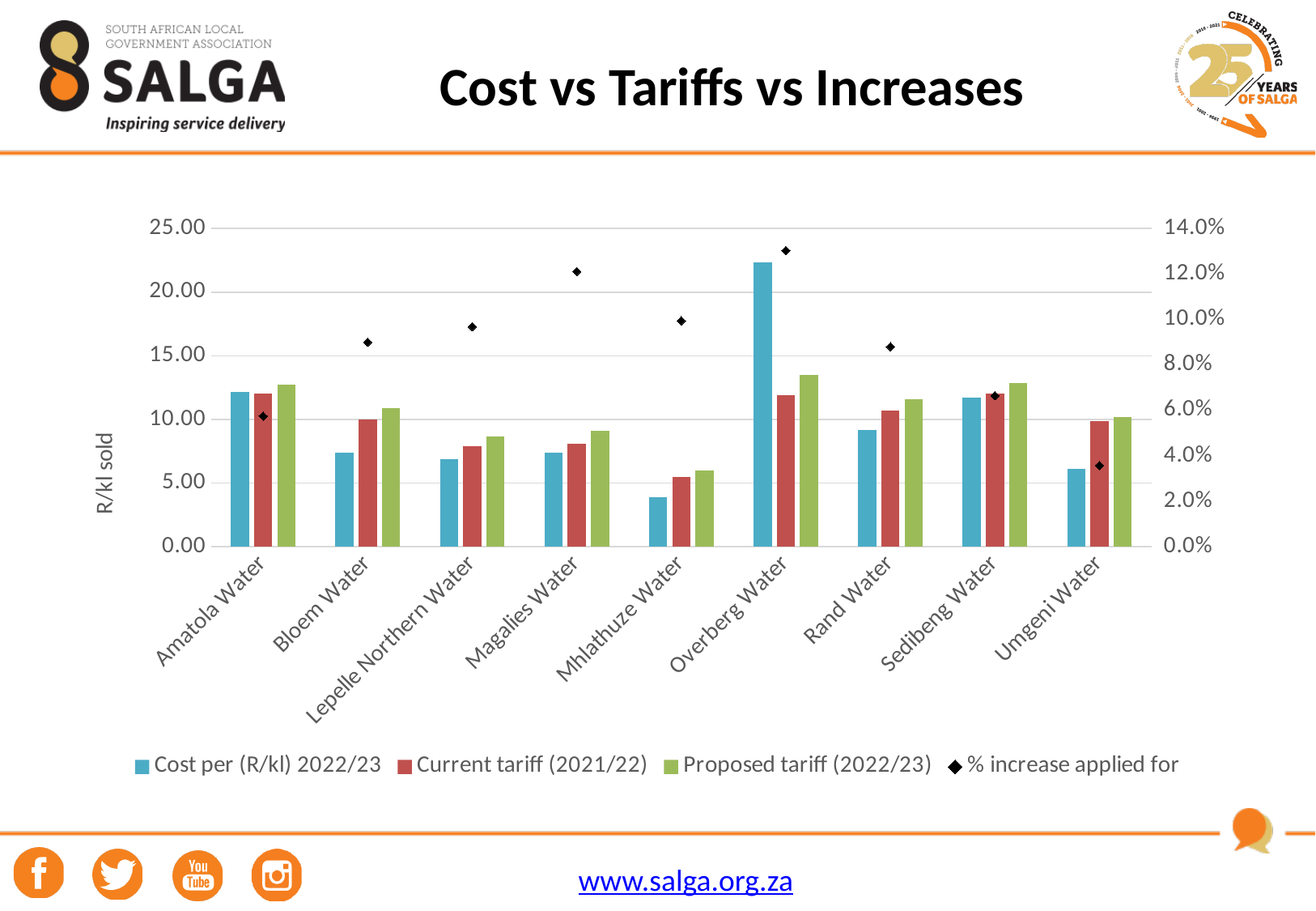
What is the title of the chart on the slide? Cost vs Tariffs vs Increases Is the % increase applied for by Magalies Water greater or less than 10.0%? greater Which water board has the highest % increase applied for? Overberg Water Which water board has the lowest Cost per (R/kl) 2022/23? Mhlathuze Water How many series does the legend list? 4 What kind of chart is shown on the slide? combination bar and line chart (bars with a diamond-marker series on a secondary axis) How many water boards (categories) are shown on the x axis? 9 Is the Cost per (R/kl) 2022/23 for Overberg Water greater or less than 20.00? greater For Bloem Water, which is larger: the Cost per (R/kl) 2022/23 or the Current tariff (2021/22)? Current tariff (2021/22) Is the Cost per (R/kl) 2022/23 for Mhlathuze Water greater or less than 5.00? less Which water board has the lowest % increase applied for? Umgeni Water Which water board has the highest Cost per (R/kl) 2022/23? Overberg Water